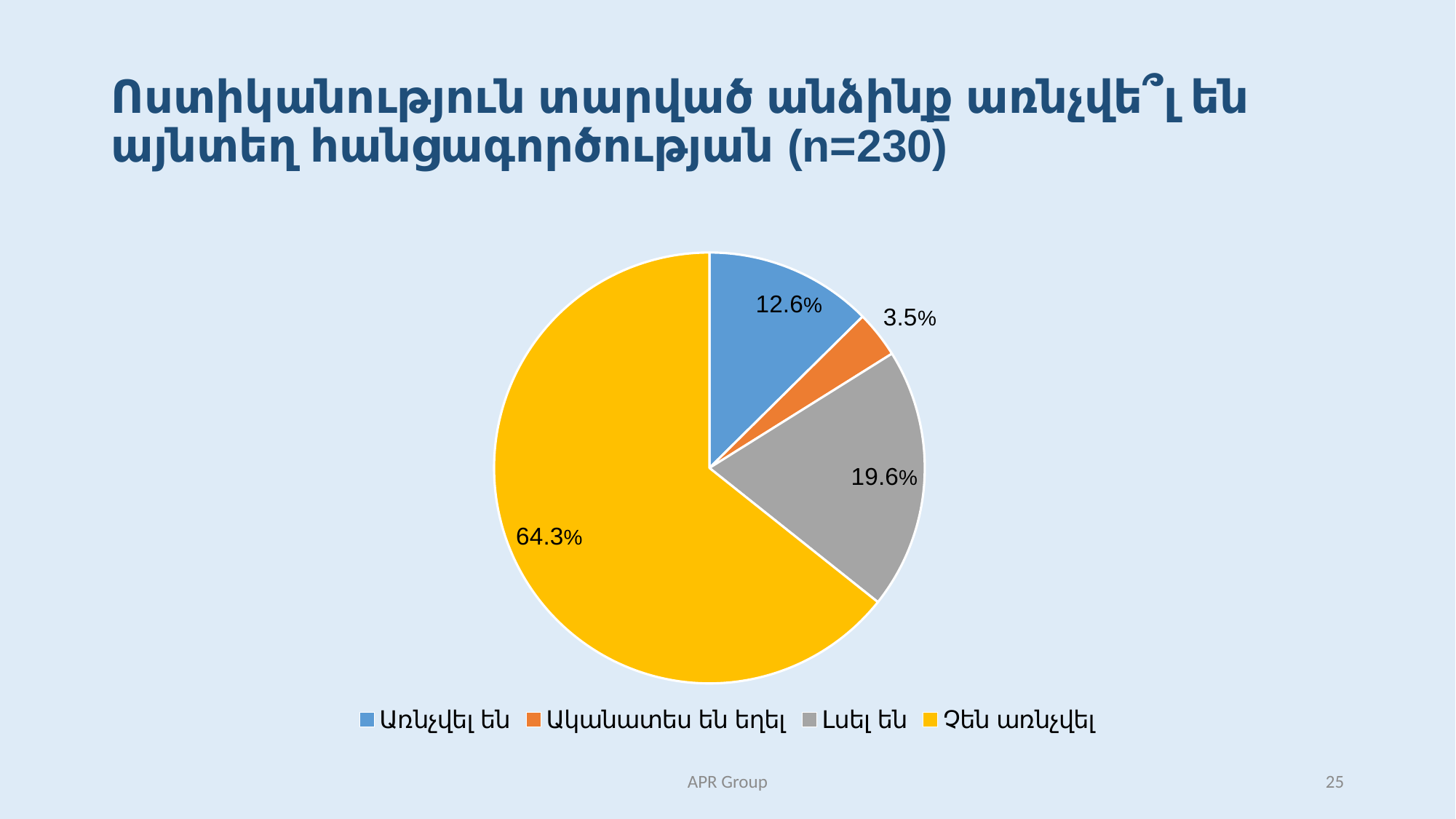
What colour is the slice for Չեն առնչվել? Yellow What share of the pie does the slice for Չեն առնչվել take? 64.3% What is the value shown for Լսել են? 19.6% What is the value shown for Ականատես են եղել? 3.5% How many categories does the pie chart have? 4 What is the difference between the values for Չեն առնչվել and Լսել են? 44.7% Which is larger, the slice for Լսել են or the slice for Առնչվել են? Լսել են Which category has the largest slice of the pie? Չեն առնչվել What is the value shown for Առնչվել են? 12.6% What is the difference between the values for Լսել են and Առնչվել են? 7.0% What kind of chart is shown on the slide? Pie chart Which category has the smallest slice of the pie? Ականատես են եղել